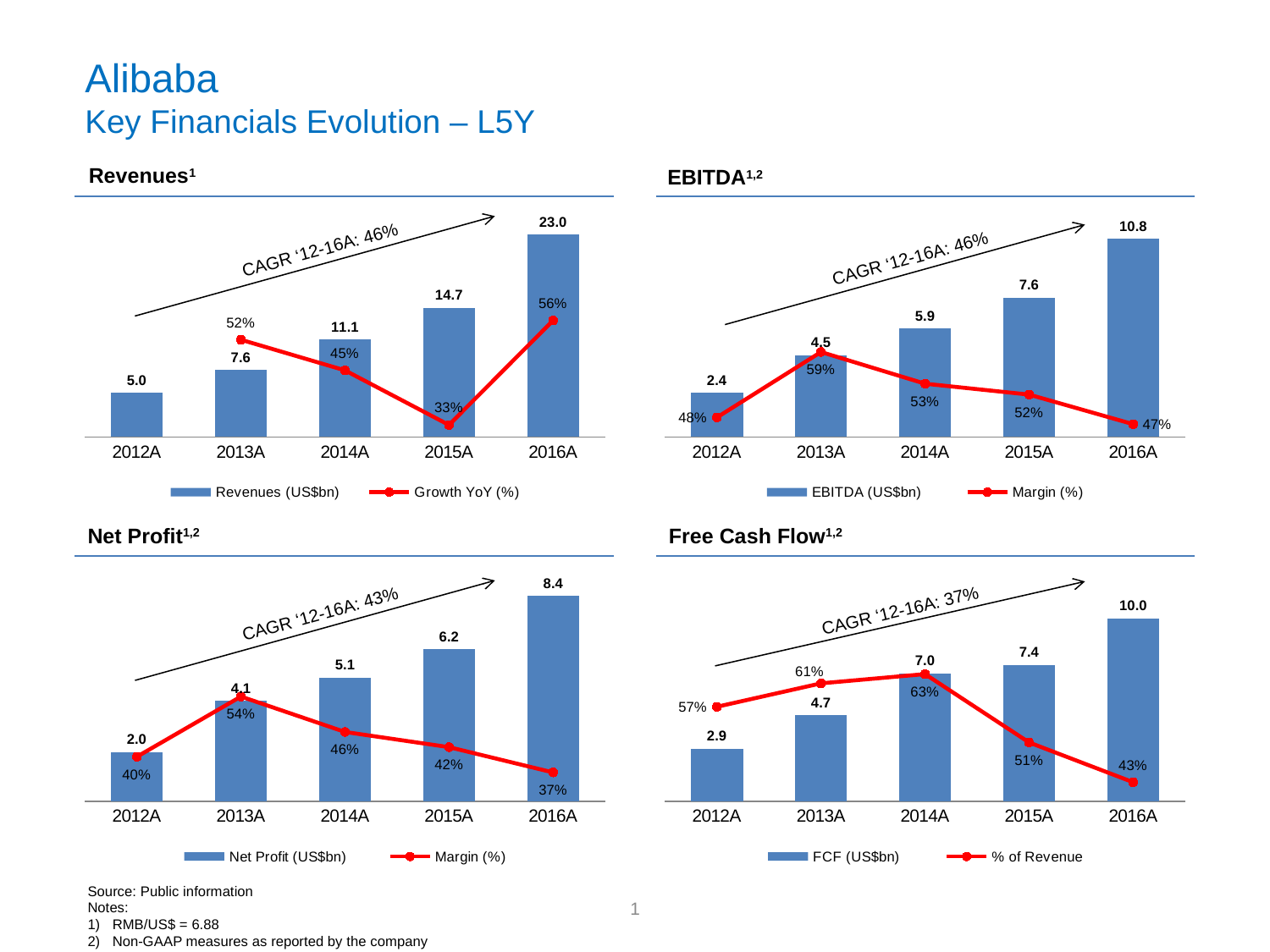
In the Free Cash Flow chart, is the % of Revenue for 2014A larger than for 2016A? Yes In the Free Cash Flow chart, how many years are shown on the x axis? 5 In the Free Cash Flow chart, what is the FCF value for 2013A? 4.7 In the Net Profit chart, which year has the lowest Margin (%)? 2016A In the EBITDA chart, what is the EBITDA value for 2014A? 5.9 In the Revenues chart, what is the Growth YoY (%) for 2015A? 33% What CAGR '12-16A is shown on the Free Cash Flow chart? 37% In the Net Profit chart, what is the difference between the Net Profit values for 2016A and 2015A? 2.2 In the Revenues chart, how many series does the legend list? 2 In the EBITDA chart, do the EBITDA (US$bn) bar values rise or fall from 2012A to 2016A? Rise In the Revenues chart, what is the revenue value for 2016A? 23.0 In the EBITDA chart, which year has the highest Margin (%)? 2013A